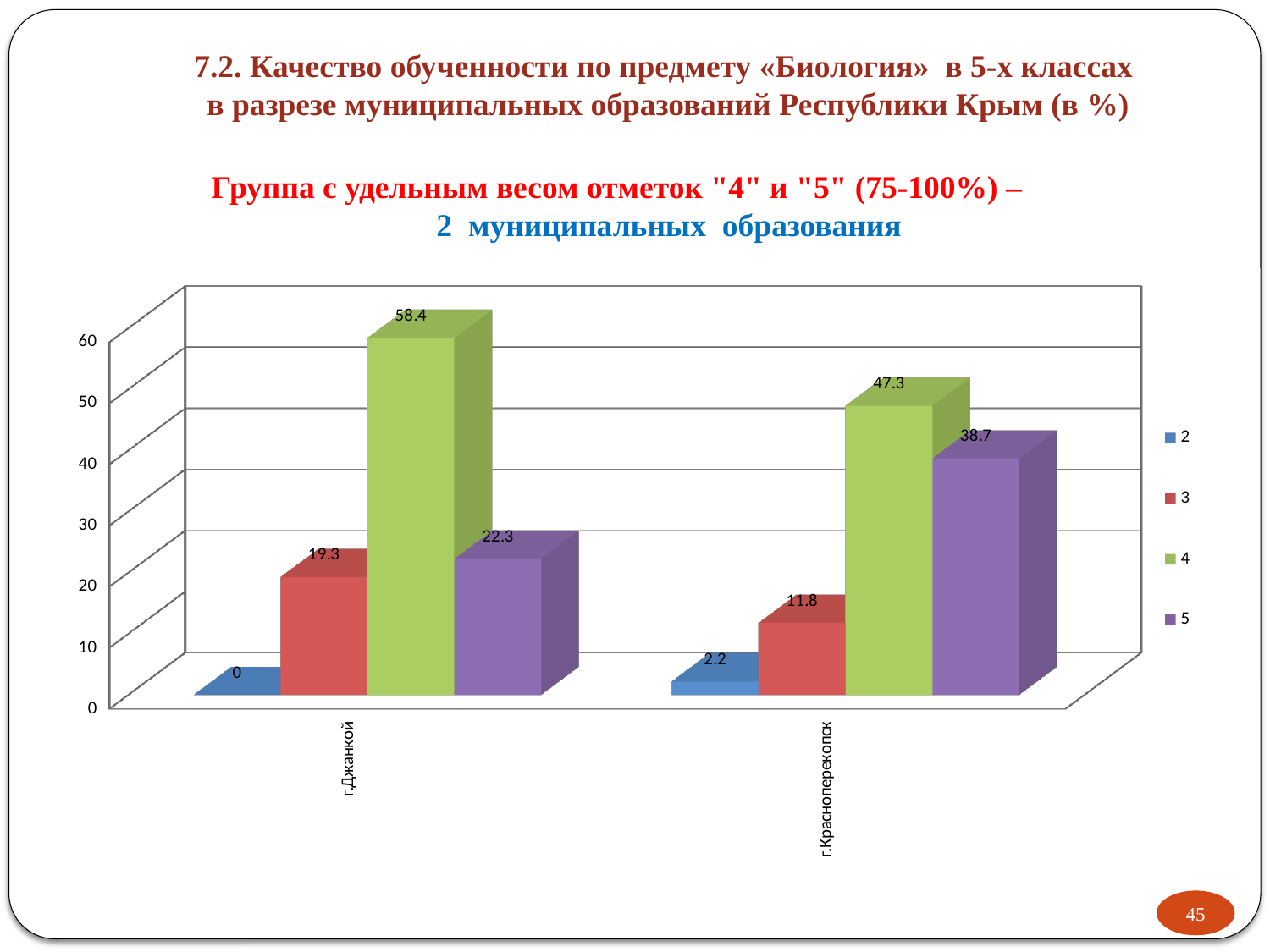
What is the value for series "5" for г.Красноперекопск? 38.7 What is the value for series "4" for г.Джанкой? 58.4 What kind of chart is shown on the slide? bar chart Which series has the lowest value for г.Джанкой? 2 What is the value for series "3" for г.Красноперекопск? 11.8 Is the value for series "3" for г.Джанкой greater or less than 10? greater What is the value for series "2" for г.Джанкой? 0 How many categories (municipalities) are shown on the x axis? 2 How many series does the legend list? 4 What is the difference between the series "4" values for г.Джанкой and г.Красноперекопск? 11.1 Which is larger: the series "5" value for г.Джанкой or for г.Красноперекопск? г.Красноперекопск Which series has the highest value for г.Красноперекопск? 4